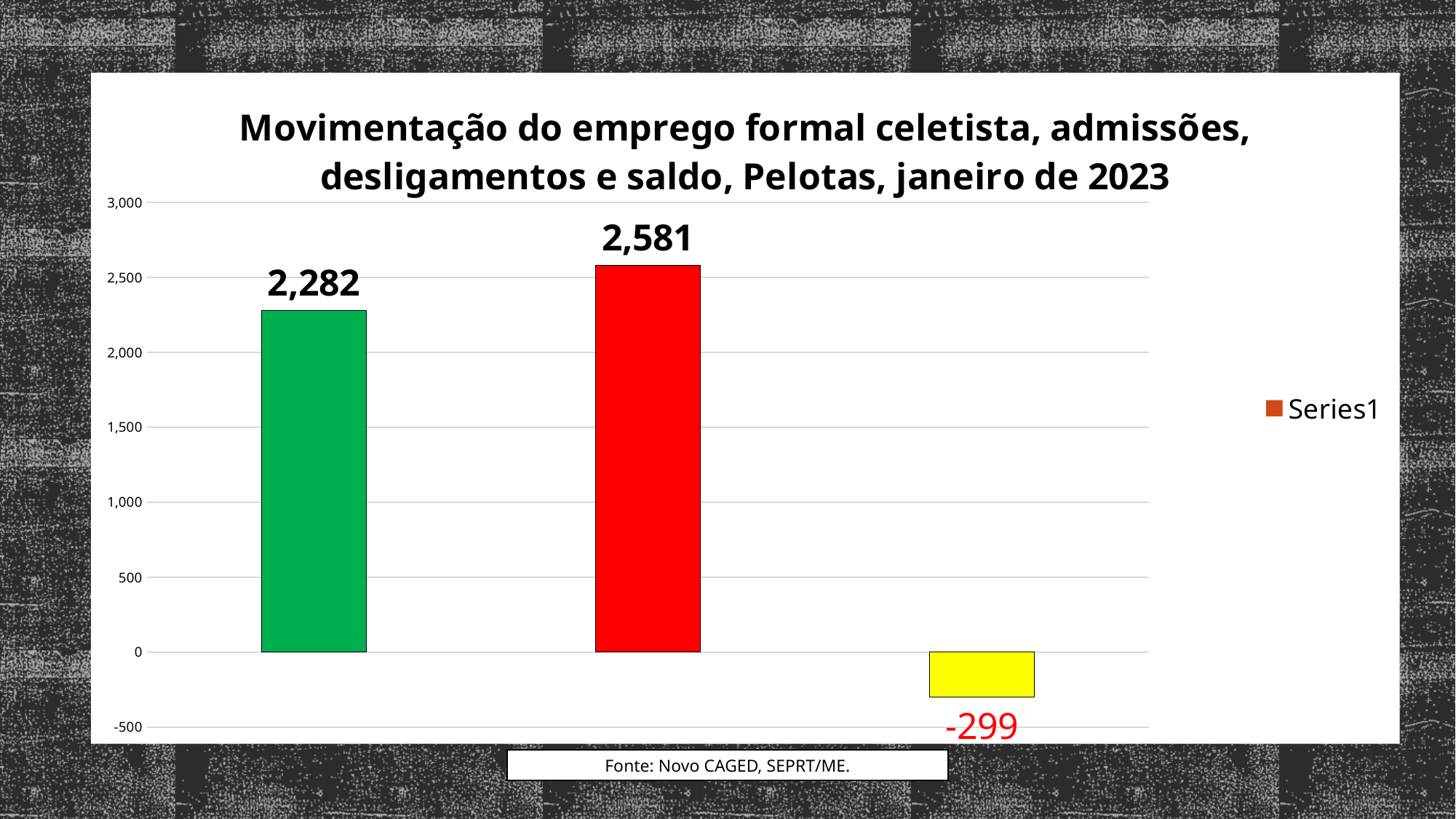
Which bar has the highest value? The red (middle) bar How many series does the legend list? 1 What kind of chart is shown on the slide? Bar chart What is the value shown on the green bar (the first bar from the left)? 2,282 Is the value of the green bar greater or less than 2,000? greater What is the difference between the red bar's value and the green bar's value? 299 What is the value shown on the yellow bar (the rightmost bar)? -299 What is the name of the series shown in the legend? Series1 Which is larger, the value of the green bar or the value of the red bar? The red bar Which bar has the lowest value? The yellow (rightmost) bar How many bars are plotted in the chart? 3 What is the value shown on the red bar (the middle bar)? 2,581